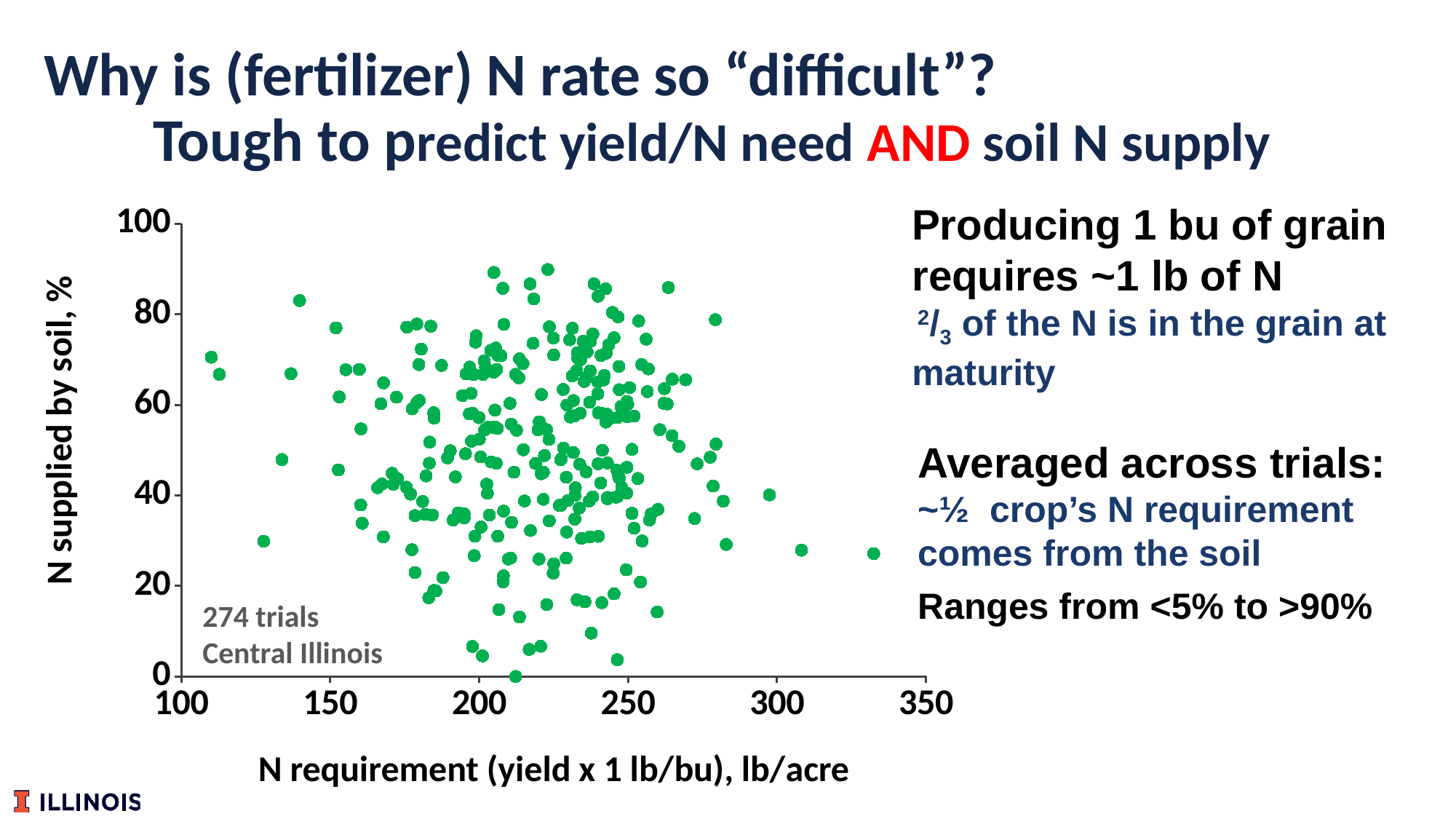
Is the N requirement value for the leftmost point in the chart greater or less than 150? less What kind of chart is shown on the slide? scatter plot How many trials are plotted in the chart? 274 What is the label of the y axis of the chart? N supplied by soil, % Is the N supplied by soil value for the highest point in the chart greater or less than 80? greater What is the label of the x axis of the chart? N requirement (yield x 1 lb/bu), lb/acre Is the N supplied by soil value for the rightmost point in the chart greater or less than 40? less